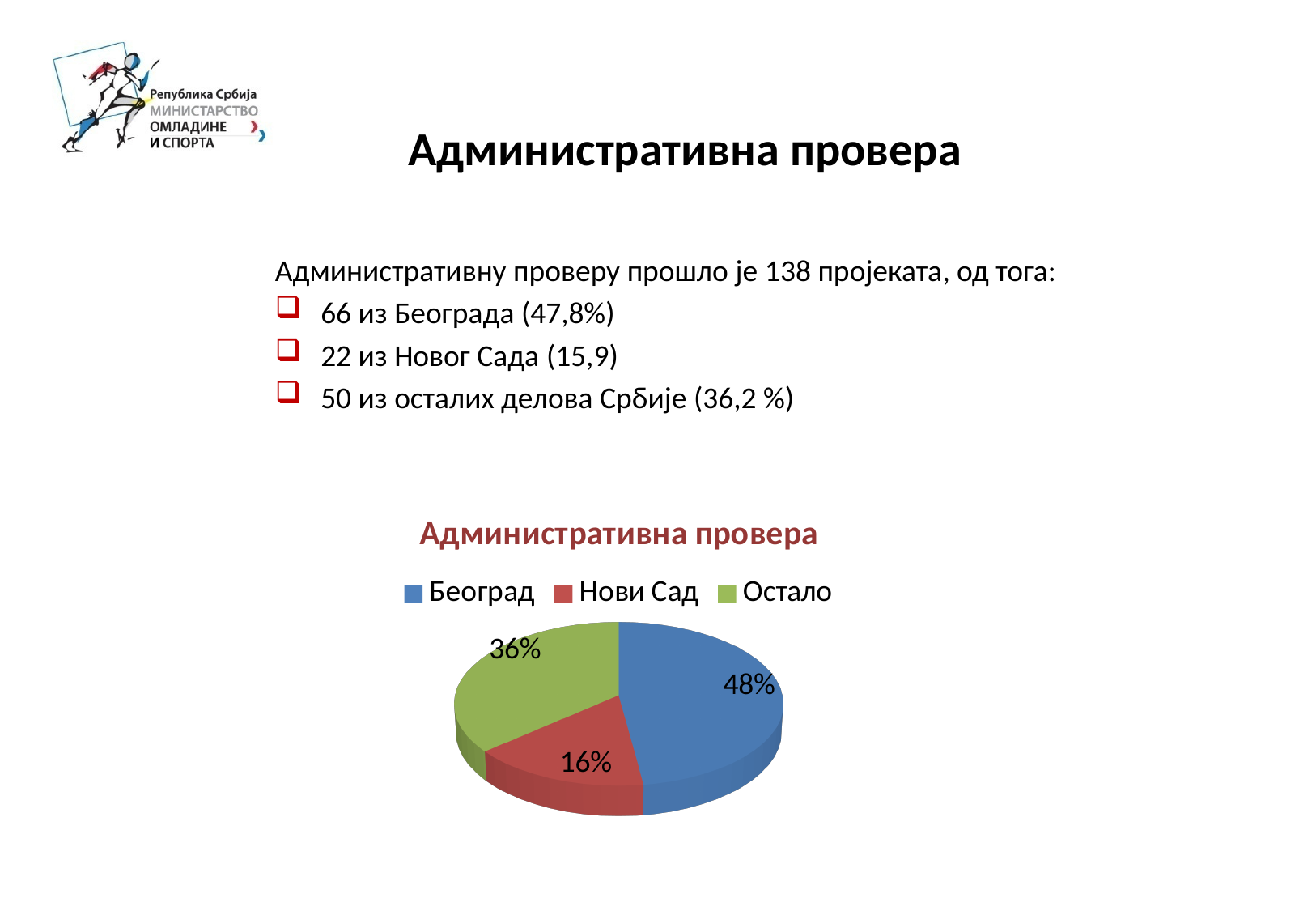
What colour is the Остало slice in the pie chart? Green What is the difference in percentage points between the Београд and Нови Сад slices? 32 What percentage is shown for Београд in the pie chart? 48% Which category has the largest slice of the pie chart? Београд What is the title of the chart? Административна провера How many slices does the pie chart have? 3 What percentage is shown for Нови Сад in the pie chart? 16% What percentage is shown for Остало in the pie chart? 36% What type of chart is shown on the slide? Pie chart How many entries does the chart legend list? 3 Which slice is larger, Остало or Нови Сад? Остало Which category has the smallest slice of the pie chart? Нови Сад